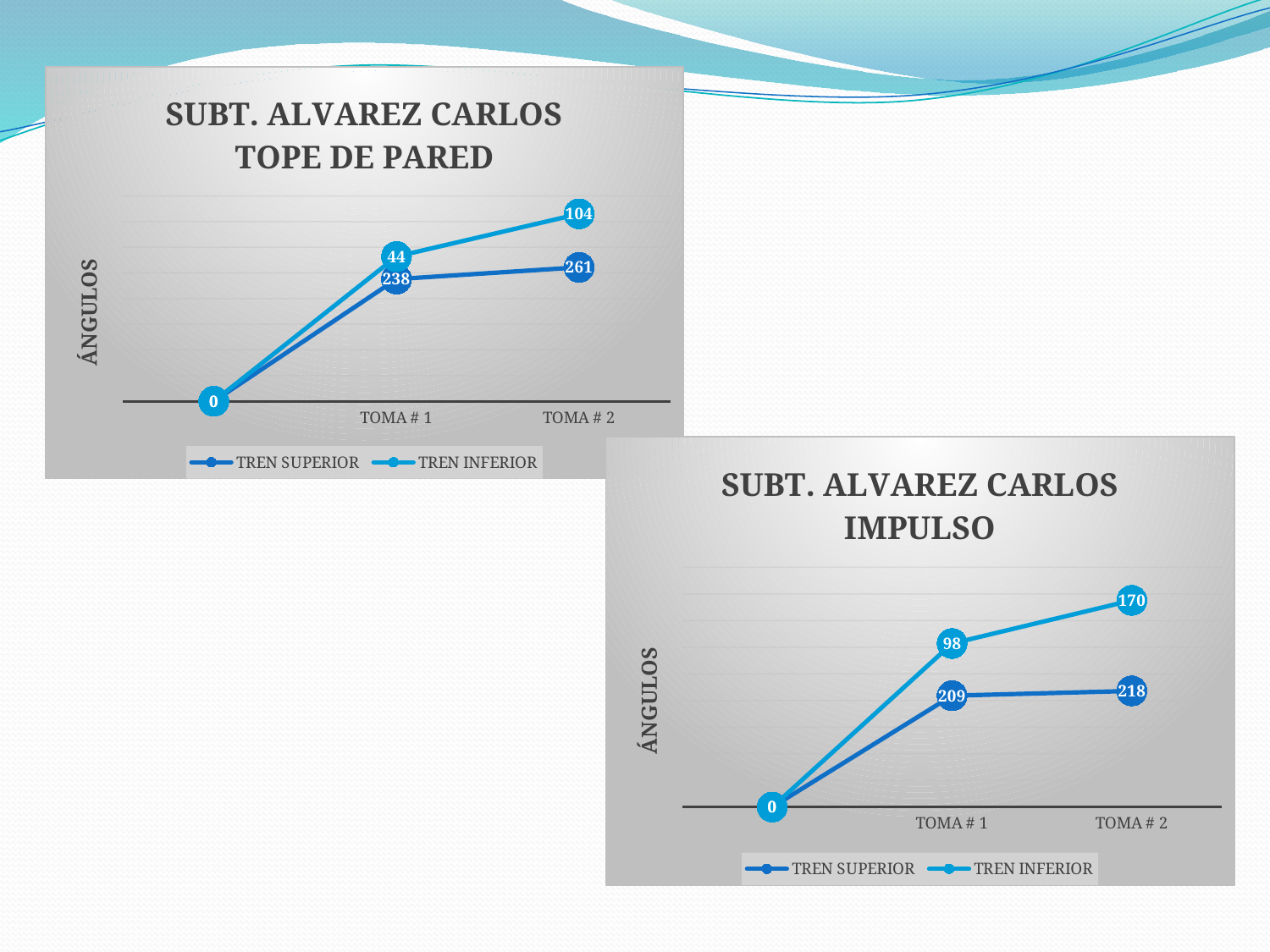
In the 'SUBT. ALVAREZ CARLOS TOPE DE PARED' chart, what is the difference between the TREN SUPERIOR values at TOMA # 2 and TOMA # 1? 23 In the 'SUBT. ALVAREZ CARLOS TOPE DE PARED' chart, what is the value of TREN INFERIOR at TOMA # 1? 44 In the 'SUBT. ALVAREZ CARLOS TOPE DE PARED' chart, what is the value of TREN INFERIOR at TOMA # 2? 104 In the 'SUBT. ALVAREZ CARLOS IMPULSO' chart, how many series does the legend list? 2 What is the y-axis title of the 'SUBT. ALVAREZ CARLOS TOPE DE PARED' chart? ÁNGULOS In the 'SUBT. ALVAREZ CARLOS IMPULSO' chart, what is the value of TREN INFERIOR at TOMA # 1? 98 In the 'SUBT. ALVAREZ CARLOS IMPULSO' chart, what is the value of TREN INFERIOR at TOMA # 2? 170 In the 'SUBT. ALVAREZ CARLOS IMPULSO' chart, what is the difference between the TREN INFERIOR values at TOMA # 2 and TOMA # 1? 72 In the 'SUBT. ALVAREZ CARLOS TOPE DE PARED' chart, what is the value of TREN SUPERIOR at TOMA # 1? 238 In the 'SUBT. ALVAREZ CARLOS TOPE DE PARED' chart, does the TREN INFERIOR series rise or fall from TOMA # 1 to TOMA # 2? rise In the 'SUBT. ALVAREZ CARLOS IMPULSO' chart, what is the value of TREN SUPERIOR at TOMA # 2? 218 What kind of chart is the 'SUBT. ALVAREZ CARLOS IMPULSO' chart? line chart